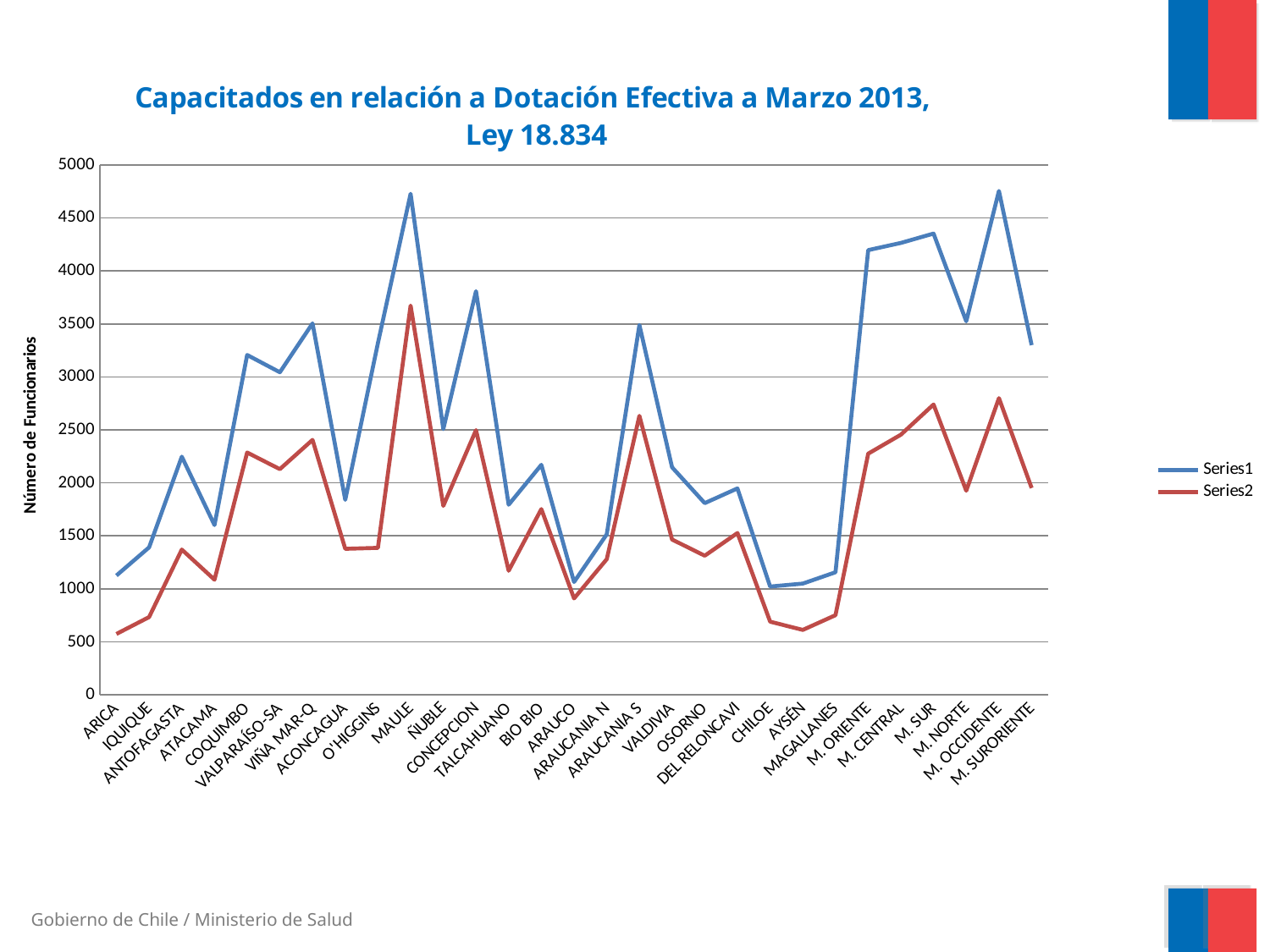
How many series does the legend list? 2 Is the Series1 value for CONCEPCION greater or less than 3500? greater Which category has the highest value for Series2? MAULE At MAULE, which series has the larger value, Series1 or Series2? Series1 Is the Series1 value for MAULE greater or less than 4500? greater Is the Series1 value for M. ORIENTE greater or less than 4000? greater What kind of chart is shown on the slide? line chart Does the Series1 line rise or fall from ARICA to ANTOFAGASTA? rise What is the title of the vertical axis? Número de Funcionarios How many categories are shown along the x axis? 29